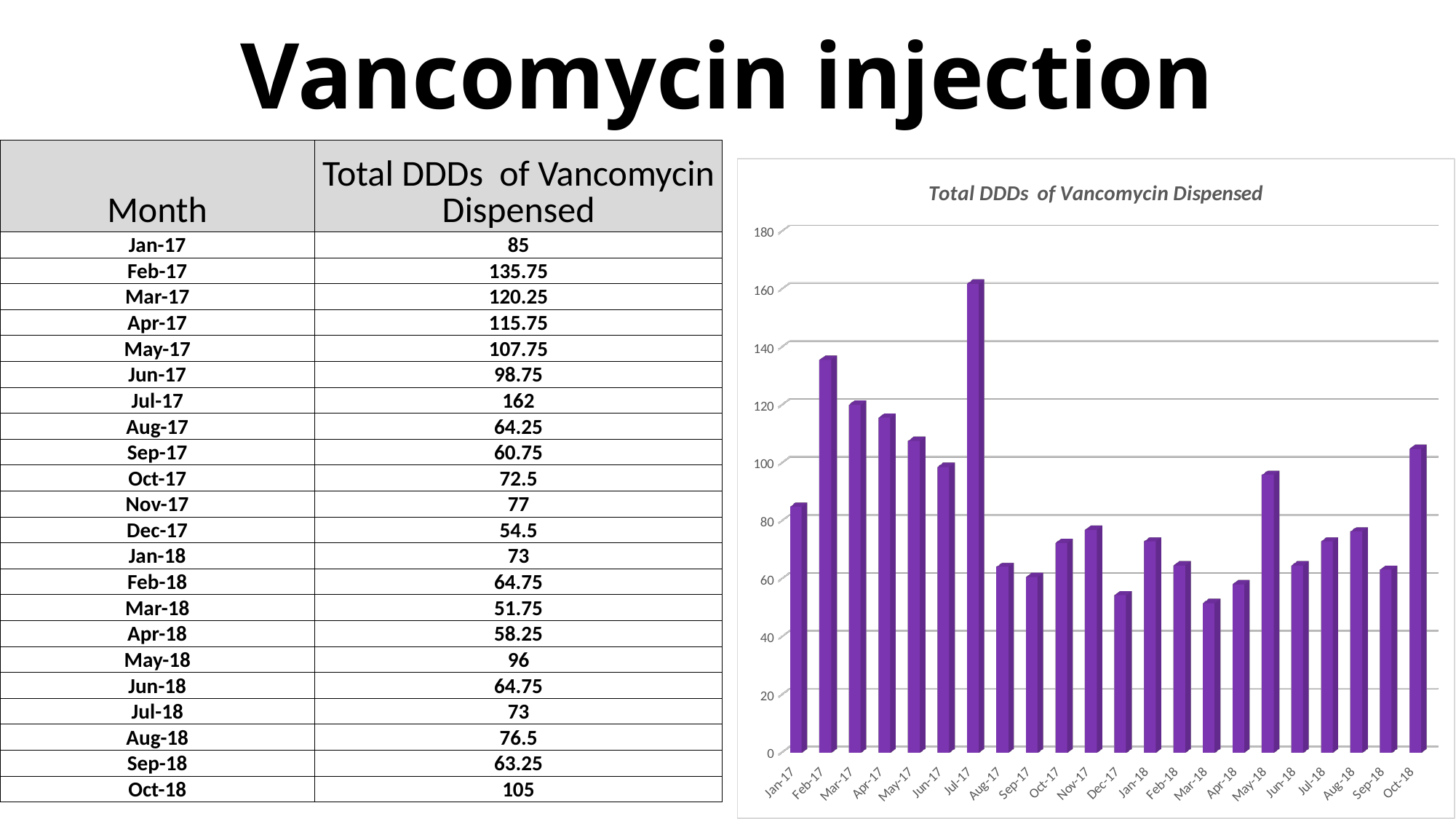
How many months are plotted in the chart? 22 What is the total DDDs of vancomycin dispensed in Jul-17? 162 What is the total DDDs of vancomycin dispensed in Feb-17? 135.75 Do the values rise or fall from Feb-17 to Jun-17? fall What is the difference in total DDDs dispensed between Jul-17 and Aug-17? 97.75 What type of chart is shown on the slide? bar chart Which month has the highest total DDDs of vancomycin dispensed? Jul-17 What is the total DDDs of vancomycin dispensed in Oct-18? 105 Which month has the lowest total DDDs of vancomycin dispensed? Mar-18 Which month has a higher value, May-18 or Jun-18? May-18 What is the title of the chart? Total DDDs of Vancomycin Dispensed Is the value for Jul-17 greater or less than 160? greater